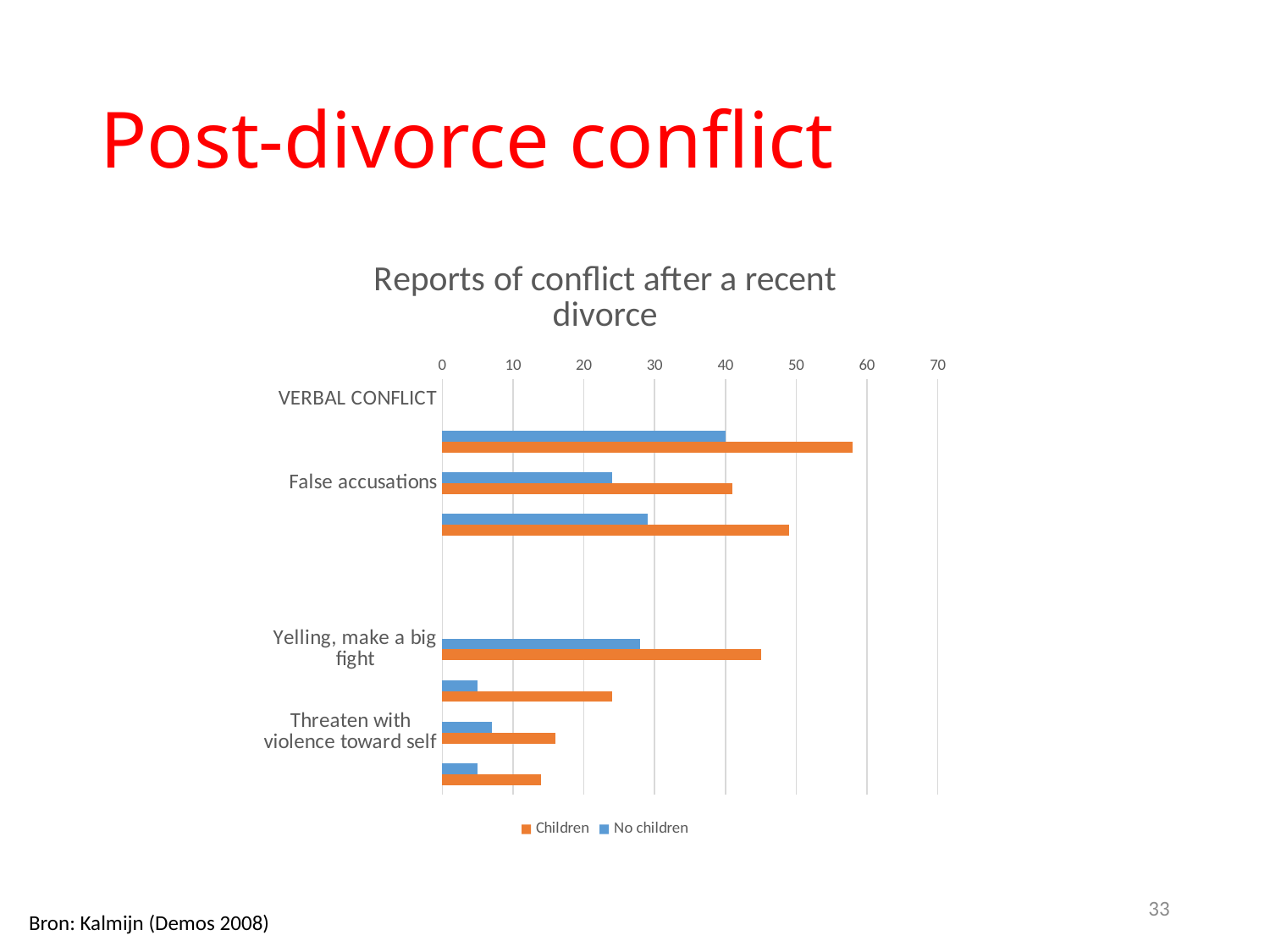
Is the No children value for Threaten with violence toward self greater or less than 10? less Which two series are listed in the legend? Children and No children What is the title of the chart? Reports of conflict after a recent divorce How many series does the legend list? 2 Is the Children value for Threaten with violence toward self greater or less than 20? less What kind of chart is shown on the slide? bar chart Is the No children value for False accusations greater or less than 20? greater Among False accusations, Yelling, make a big fight, and Threaten with violence toward self, which has the lowest Children value? Threaten with violence toward self For False accusations, which series has the larger value, Children or No children? Children